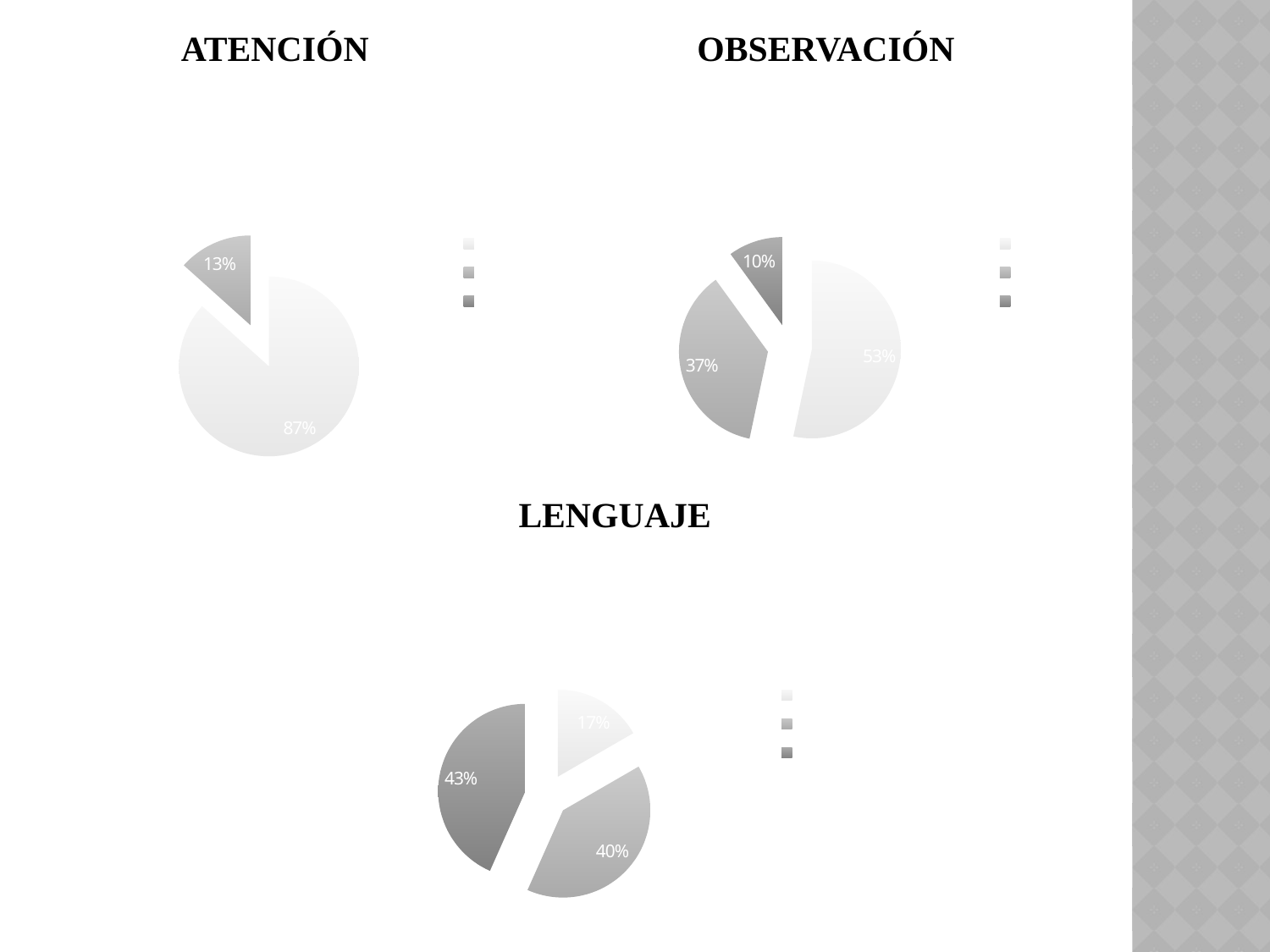
In the OBSERVACIÓN chart, what is the share of the largest slice? 53% In the LENGUAJE chart, what is the share of the smallest slice? 17% How many slices does the LENGUAJE pie chart show? 3 How many slices does the OBSERVACIÓN pie chart show? 3 What type of chart is used for ATENCIÓN? pie chart In the OBSERVACIÓN chart, what is the difference between the 53% slice and the 37% slice? 16% In the OBSERVACIÓN chart, what is the share of the smallest slice? 10% In the ATENCIÓN chart, what is the share of the largest slice? 87% In the ATENCIÓN chart, what is the difference between the largest and smallest slices? 74% In the LENGUAJE chart, what is the share of the largest slice? 43% How many pie charts are shown on the slide? 3 In the ATENCIÓN chart, what is the share of the smallest slice? 13%